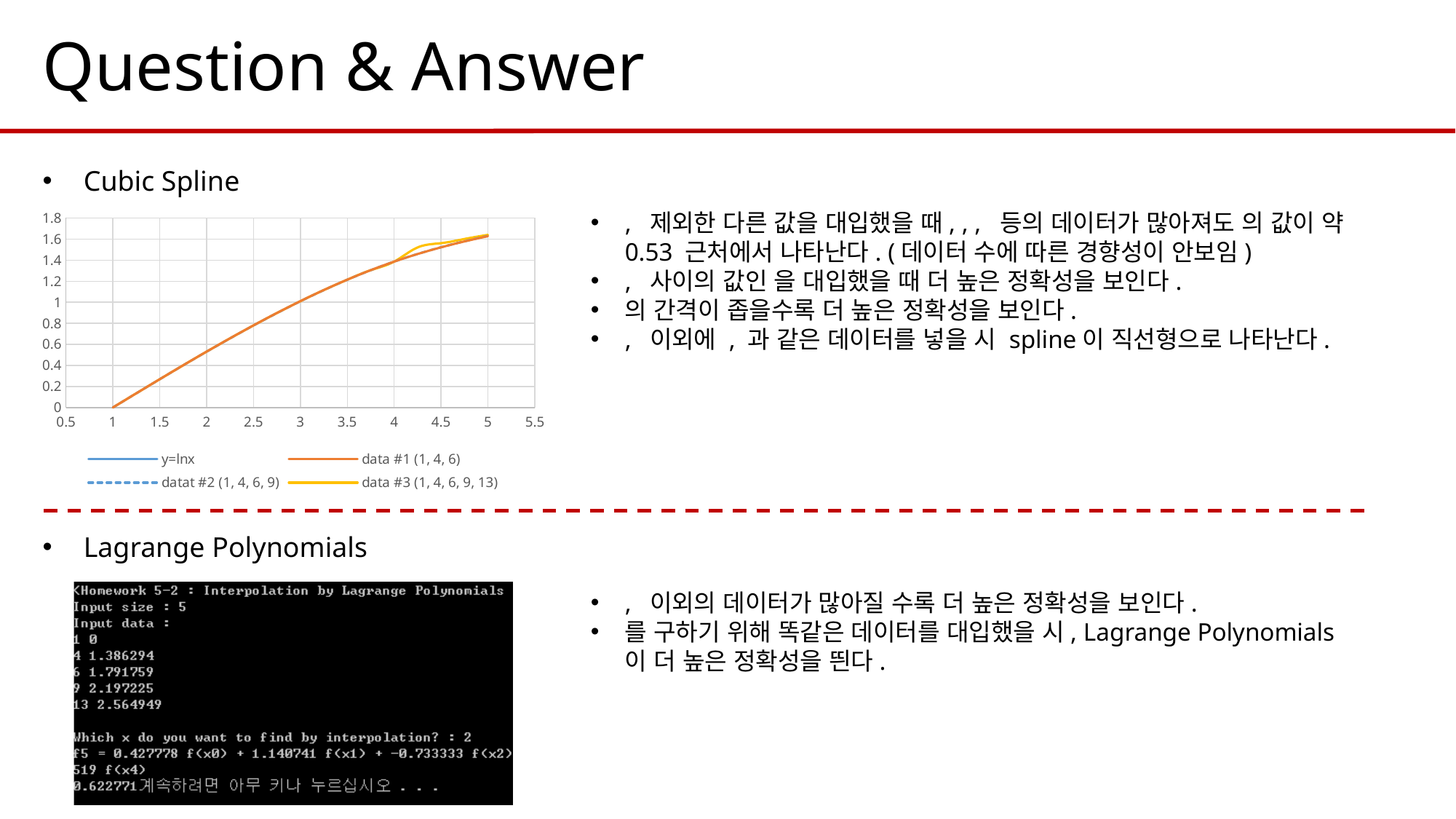
In the Cubic Spline chart, is the value of the y=lnx series at x=4 greater or less than 1.2? greater In the Cubic Spline chart, is the value of the y=lnx series at x=1 greater or less than 0.2? less In the Cubic Spline chart, is the value of the y=lnx series at x=2 greater or less than 1? less What kind of chart is shown under the Cubic Spline heading? line chart How many series does the legend of the Cubic Spline chart list? 4 What is the highest tick value shown on the y axis of the Cubic Spline chart? 1.8 In the Cubic Spline chart, do the plotted values rise or fall as x increases from 1 to 5? rise What is the first series listed in the legend of the Cubic Spline chart? y=lnx